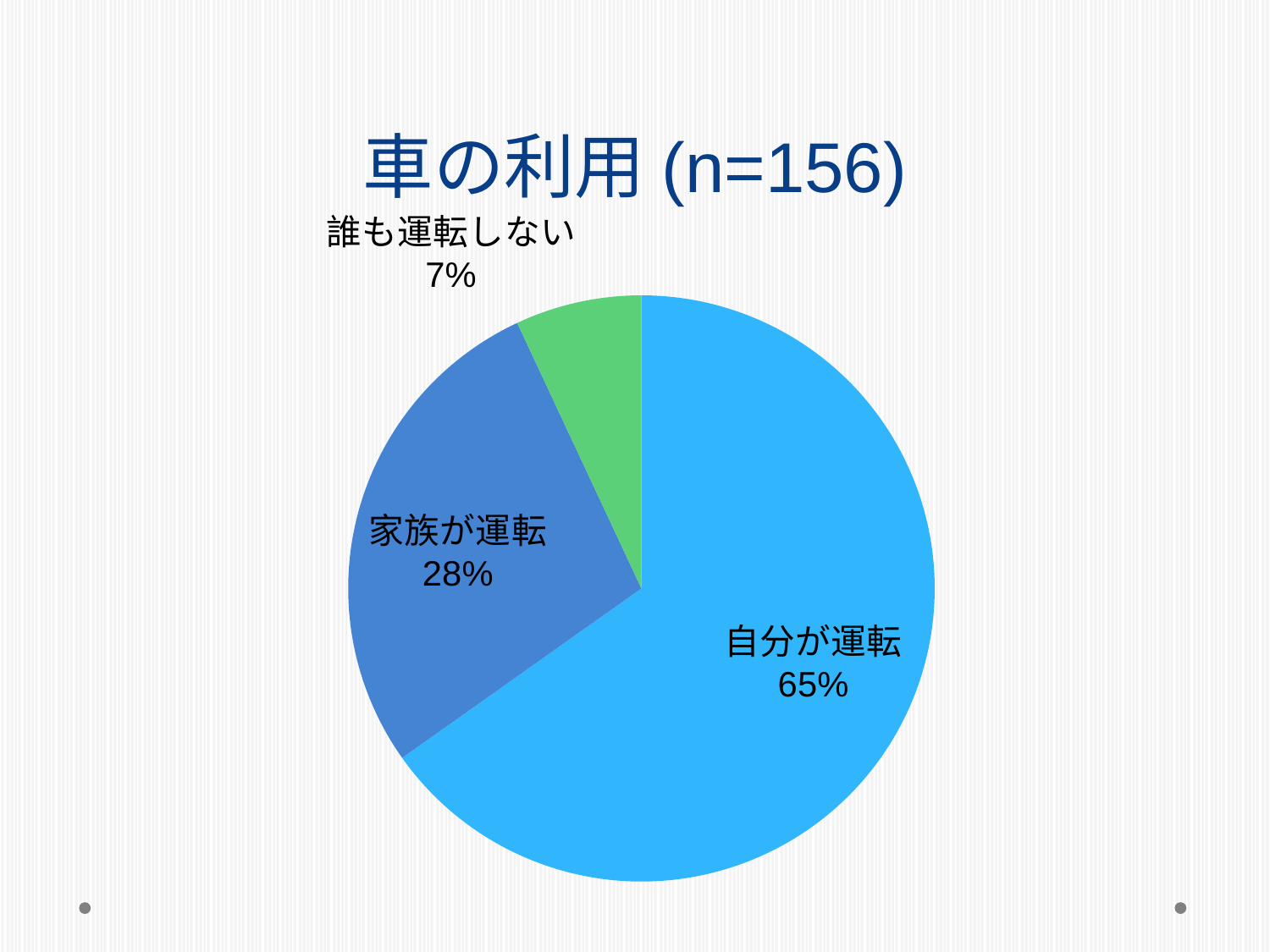
What share of the pie does 家族が運転 represent? 28% What is the difference in percentage points between 自分が運転 and 家族が運転? 37 How many categories are shown in the pie chart? 3 Which category has the smallest slice of the pie? 誰も運転しない What share of the pie does 自分が運転 represent? 65% What is the title of the chart? 車の利用 (n=156) Which is larger, the share for 家族が運転 or the share for 誰も運転しない? 家族が運転 What colour is the slice for 誰も運転しない? green Which category has the largest slice of the pie? 自分が運転 What is the difference in percentage points between 家族が運転 and 誰も運転しない? 21 What kind of chart is shown on the slide? pie chart What share of the pie does 誰も運転しない represent? 7%